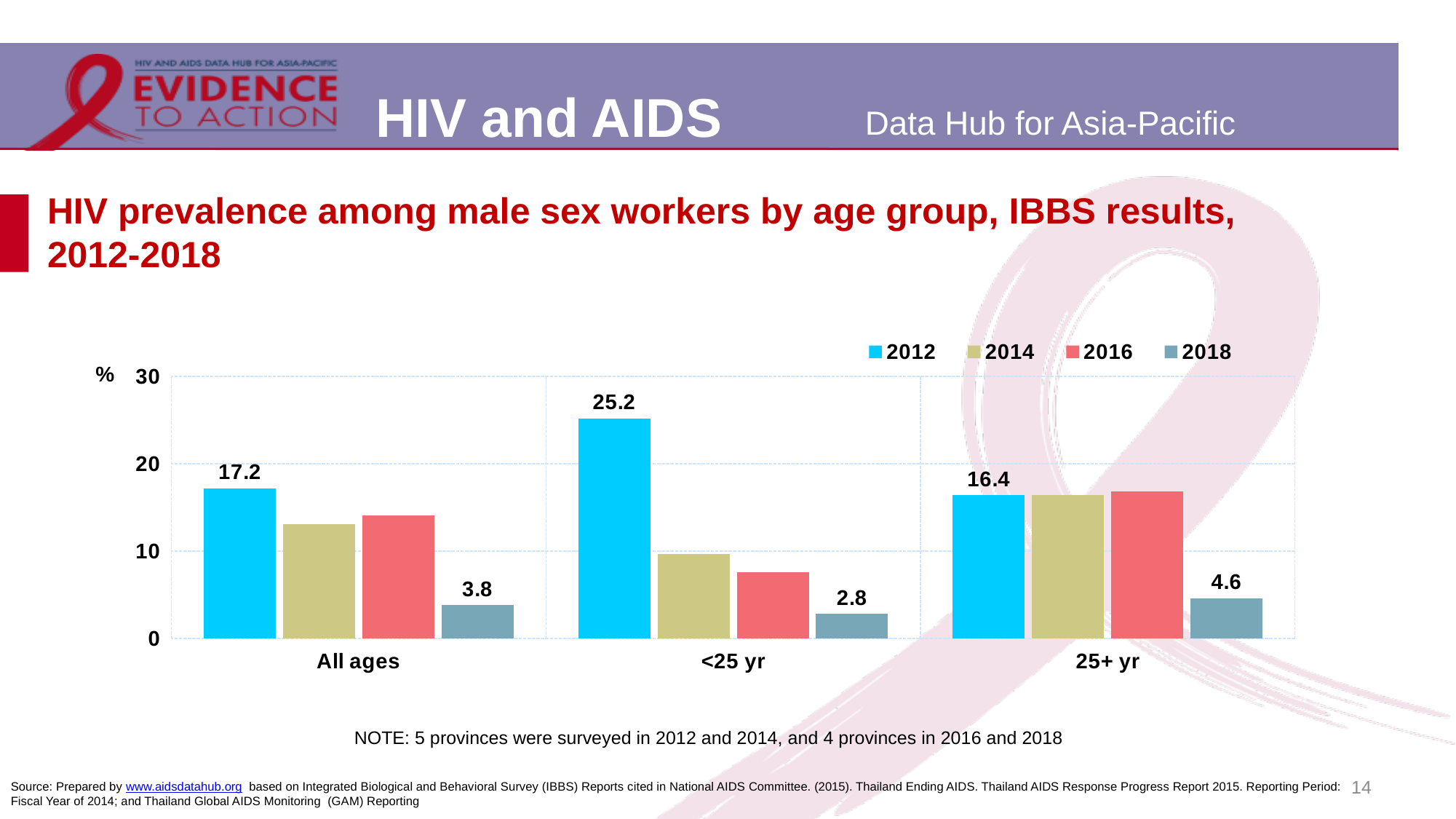
What is the 2018 value for the <25 yr age group? 2.8 Which is larger: the 2012 value for All ages or the 2012 value for 25+ yr? 2012 value for All ages Which age group has the lowest 2018 value? <25 yr What kind of chart is shown on the slide? Bar chart Which age group has the highest 2012 value? <25 yr What is the 2012 value for All ages? 17.2 How many series does the legend list? 4 What is the difference between the 2012 and 2018 values for the <25 yr age group? 22.4 How many age group categories are shown on the x axis? 3 What is the 2018 value for the 25+ yr age group? 4.6 What is the 2012 value for the <25 yr age group? 25.2